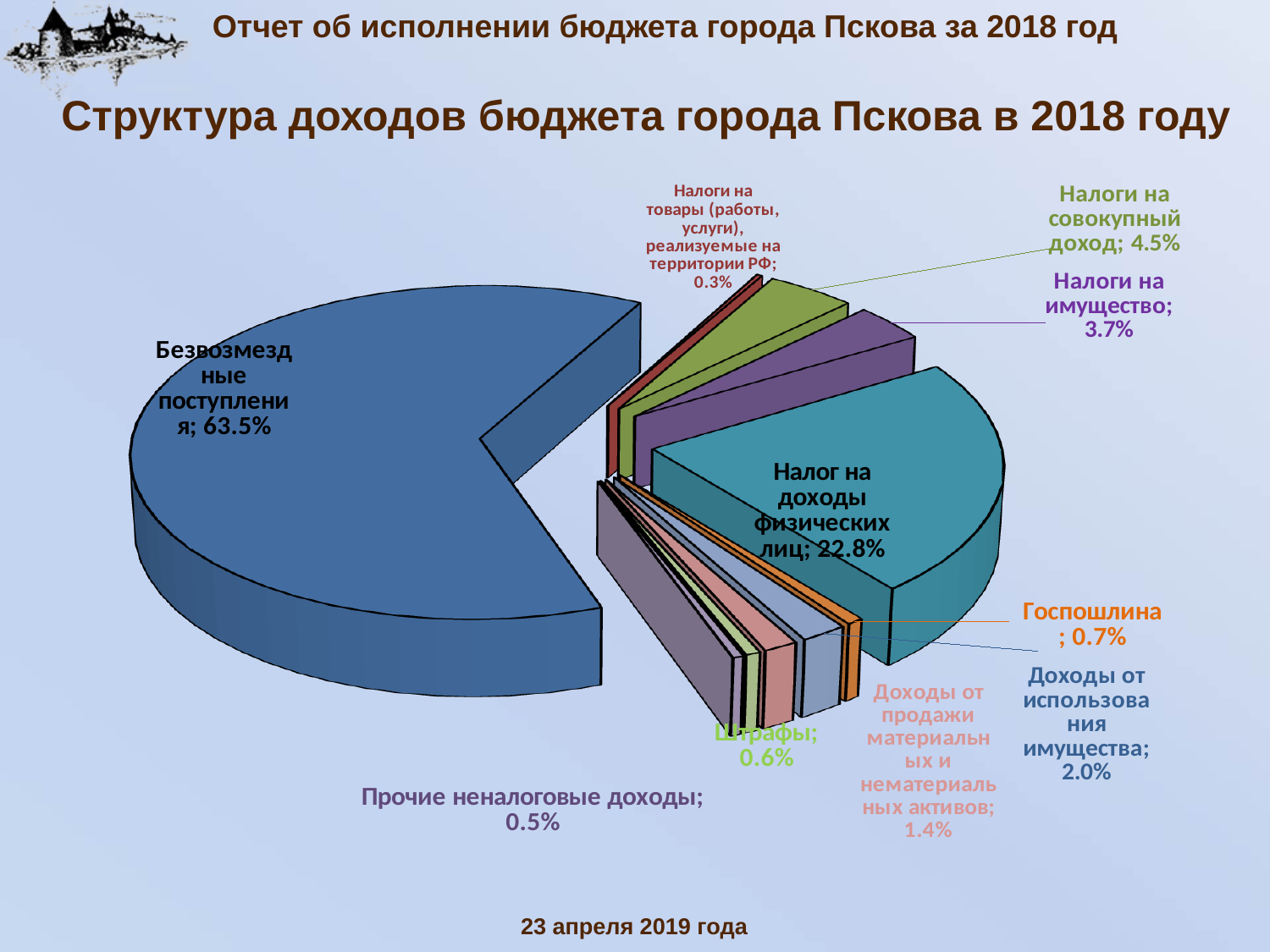
Что больше: доля «Налогов на совокупный доход» или доля «Налогов на имущество»? Налоги на совокупный доход На сколько процентных пунктов доля «Безвозмездных поступлений» больше доли «Налога на доходы физических лиц»? 40.7 Какая категория имеет наибольшую долю в структуре доходов? Безвозмездные поступления Какова доля категории «Налоги на имущество»? 3.7% Какова доля категории «Налог на доходы физических лиц»? 22.8% Какая категория имеет наименьшую долю в структуре доходов? Налоги на товары (работы, услуги), реализуемые на территории РФ Как называется диаграмма на слайде? Структура доходов бюджета города Пскова в 2018 году Какова доля категории «Безвозмездные поступления»? 63.5% Сколько категорий показано на диаграмме? 10 Какова доля категории «Доходы от использования имущества»? 2.0% Какой тип диаграммы показан на слайде? Круговая диаграмма Что больше: доля «Госпошлины» или доля «Штрафов»? Госпошлина